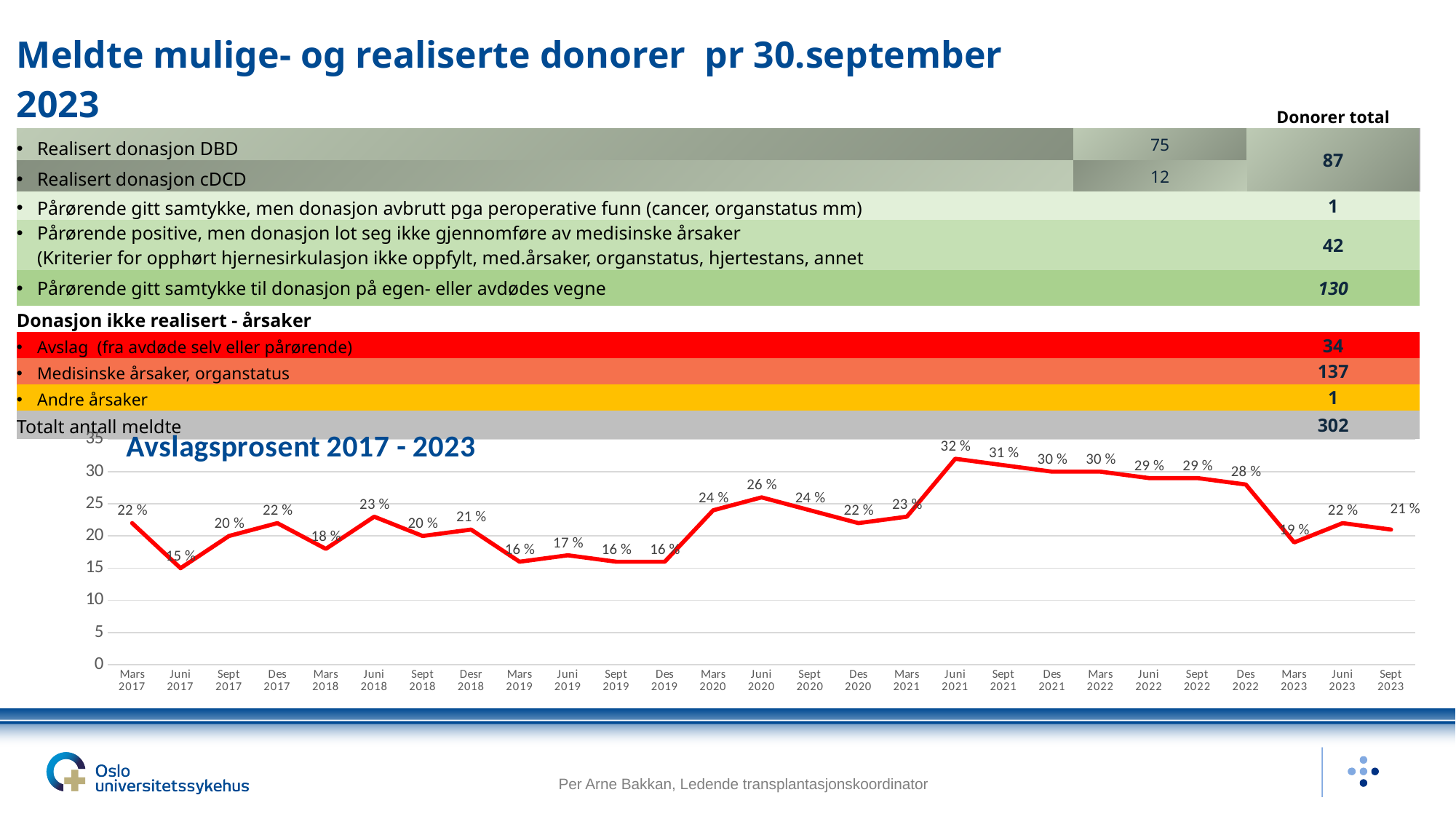
What is the value for Sept 2023 in the Avslagsprosent 2017 - 2023 chart? 21 % What is the value for Juni 2021 in the Avslagsprosent 2017 - 2023 chart? 32 % What is the value for Mars 2017 in the Avslagsprosent 2017 - 2023 chart? 22 % What is the title of the line chart on the slide? Avslagsprosent 2017 - 2023 How many data points are plotted in the Avslagsprosent 2017 - 2023 chart? 27 Which point has the highest value in the Avslagsprosent 2017 - 2023 chart? Juni 2021 In the Avslagsprosent 2017 - 2023 chart, which is larger: the value for Juni 2020 or the value for Mars 2023? Juni 2020 In the Avslagsprosent 2017 - 2023 chart, is the value for Sept 2021 greater or less than 25? greater What kind of chart is the Avslagsprosent 2017 - 2023 chart? line chart Which point has the lowest value in the Avslagsprosent 2017 - 2023 chart? Juni 2017 In the Avslagsprosent 2017 - 2023 chart, do the values rise or fall from Des 2022 to Mars 2023? fall What is the difference between the values for Juni 2021 and Juni 2017 in the Avslagsprosent 2017 - 2023 chart? 17 %